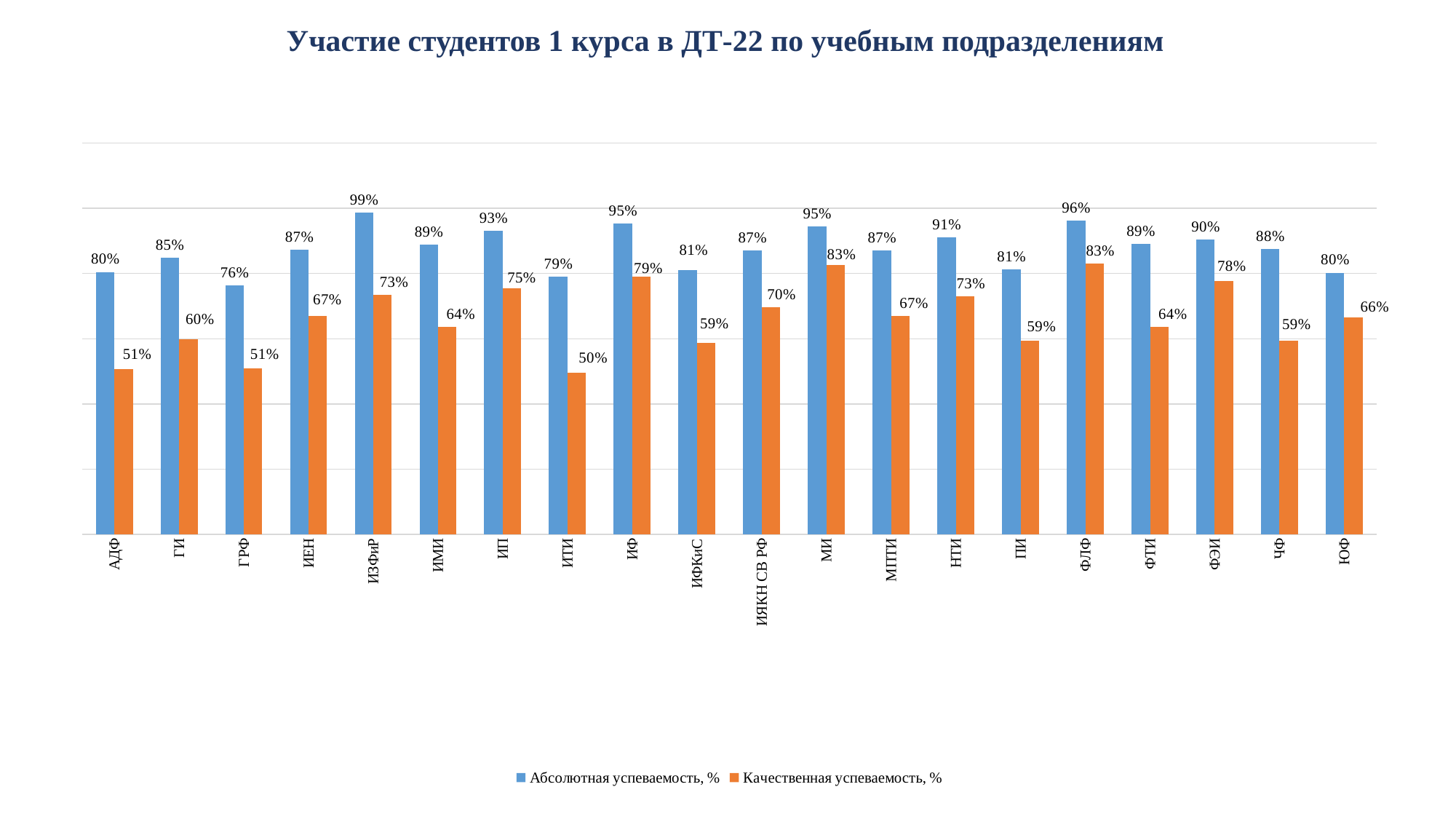
What is the Качественная успеваемость, % value for ИТИ? 50% What kind of chart is shown on the slide? Bar chart How many series does the legend list? 2 How many categories are shown on the x axis? 20 Which is larger: the Качественная успеваемость, % value for ИП or for ИМИ? ИП Which category has the highest Абсолютная успеваемость, % value? ИЗФиР What is the difference between the Абсолютная успеваемость, % and Качественная успеваемость, % values for АДФ? 29% Which category has the lowest Качественная успеваемость, % value? ИТИ What is the Абсолютная успеваемость, % value for ИЗФиР? 99% What is the title of the chart? Участие студентов 1 курса в ДТ-22 по учебным подразделениям What is the Качественная успеваемость, % value for ИЯКН СВ РФ? 70% Which category has the lowest Абсолютная успеваемость, % value? ГРФ